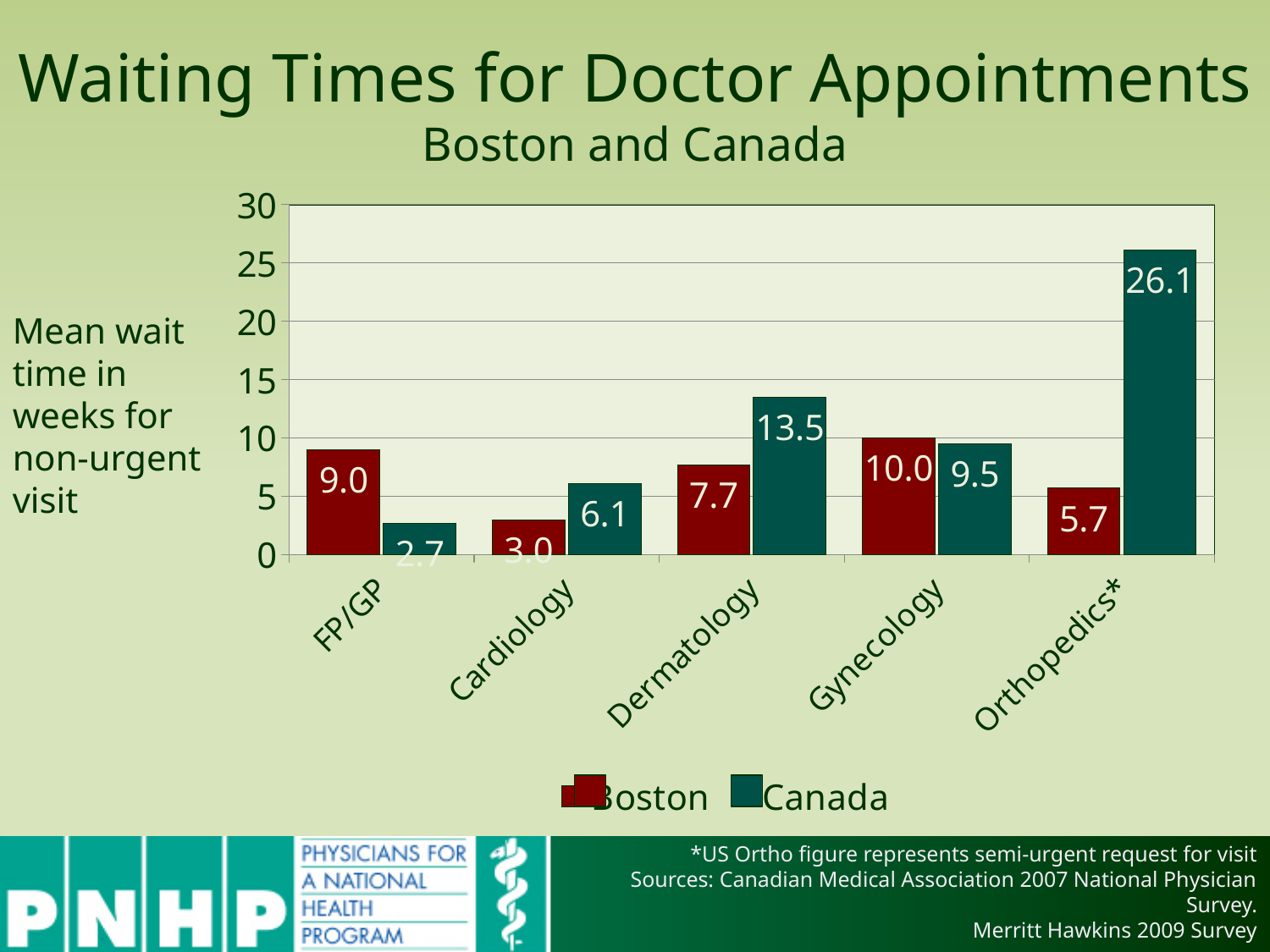
What kind of chart is shown on the slide? bar chart Is the Canada wait time for Orthopedics* greater or less than 25? greater Which specialty has the highest Canada wait time? Orthopedics* Which is larger for FP/GP, the Boston wait time or the Canada wait time? Boston What is the mean wait time in weeks for Boston for Gynecology? 10.0 Which specialty has the lowest Boston wait time? Cardiology What is the mean wait time in weeks for Canada for Orthopedics*? 26.1 How many specialties are shown on the x axis? 5 What is the mean wait time in weeks for Boston for Dermatology? 7.7 What is the mean wait time in weeks for Canada for Cardiology? 6.1 What is the difference between the Canada and Boston wait times for Dermatology? 5.8 How many series does the legend list? 2